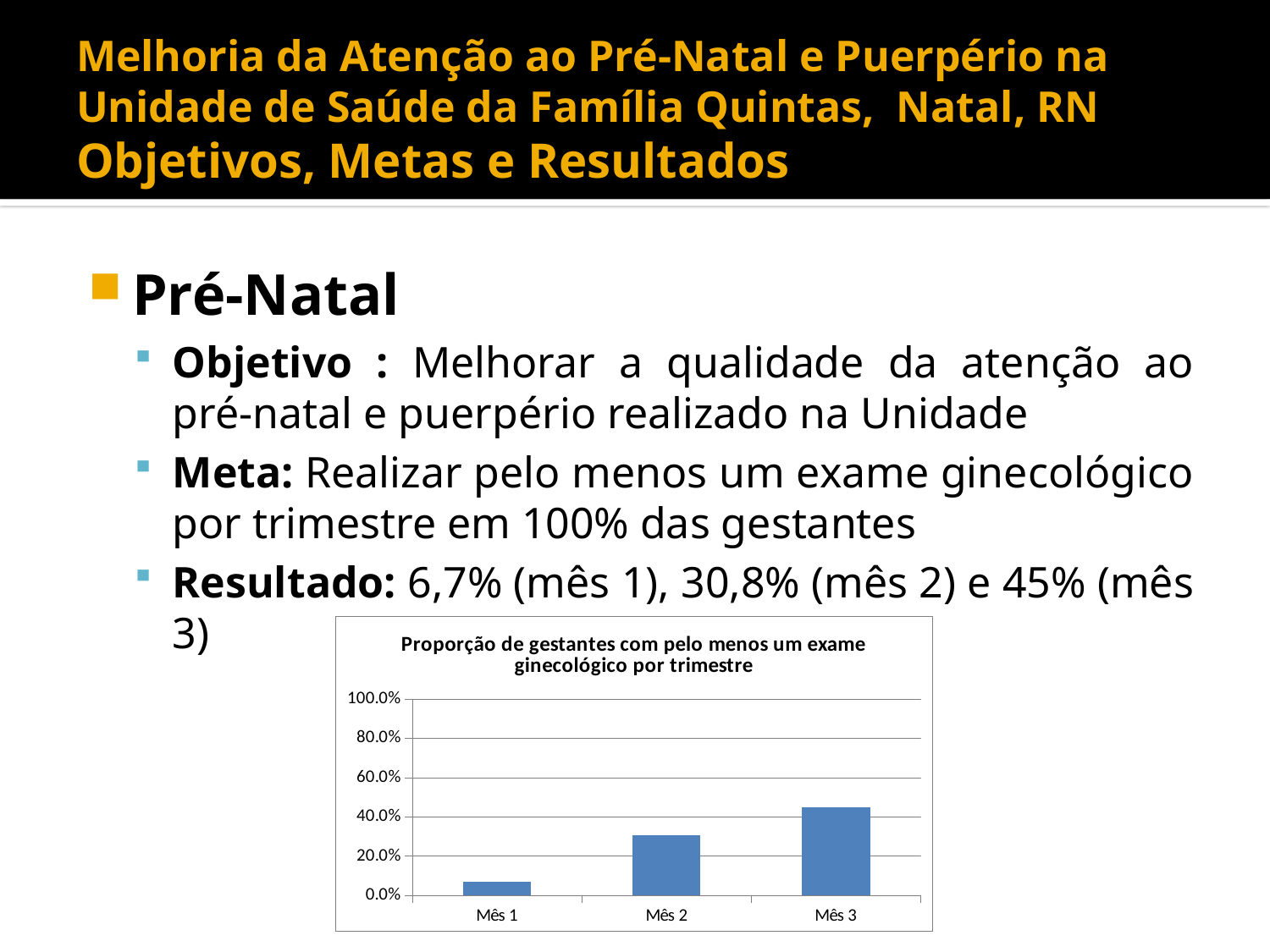
What kind of chart is shown on the slide? bar chart How many categories (months) are plotted in the chart? 3 Which month has the highest proportion in the chart? Mês 3 According to the slide, what is the proportion of pregnant women with at least one gynecological exam in mês 1? 6,7% What is the title of the chart? Proporção de gestantes com pelo menos um exame ginecológico por trimestre According to the slide, what is the proportion for mês 3? 45% Is the value for Mês 2 greater or less than 20.0%? greater Which is larger, the value for Mês 2 or the value for Mês 3? Mês 3 Is the value for Mês 1 greater or less than 20.0%? less Do the values rise or fall from Mês 1 to Mês 3? rise Is the value for Mês 3 greater or less than 40.0%? greater Which month has the lowest proportion in the chart? Mês 1